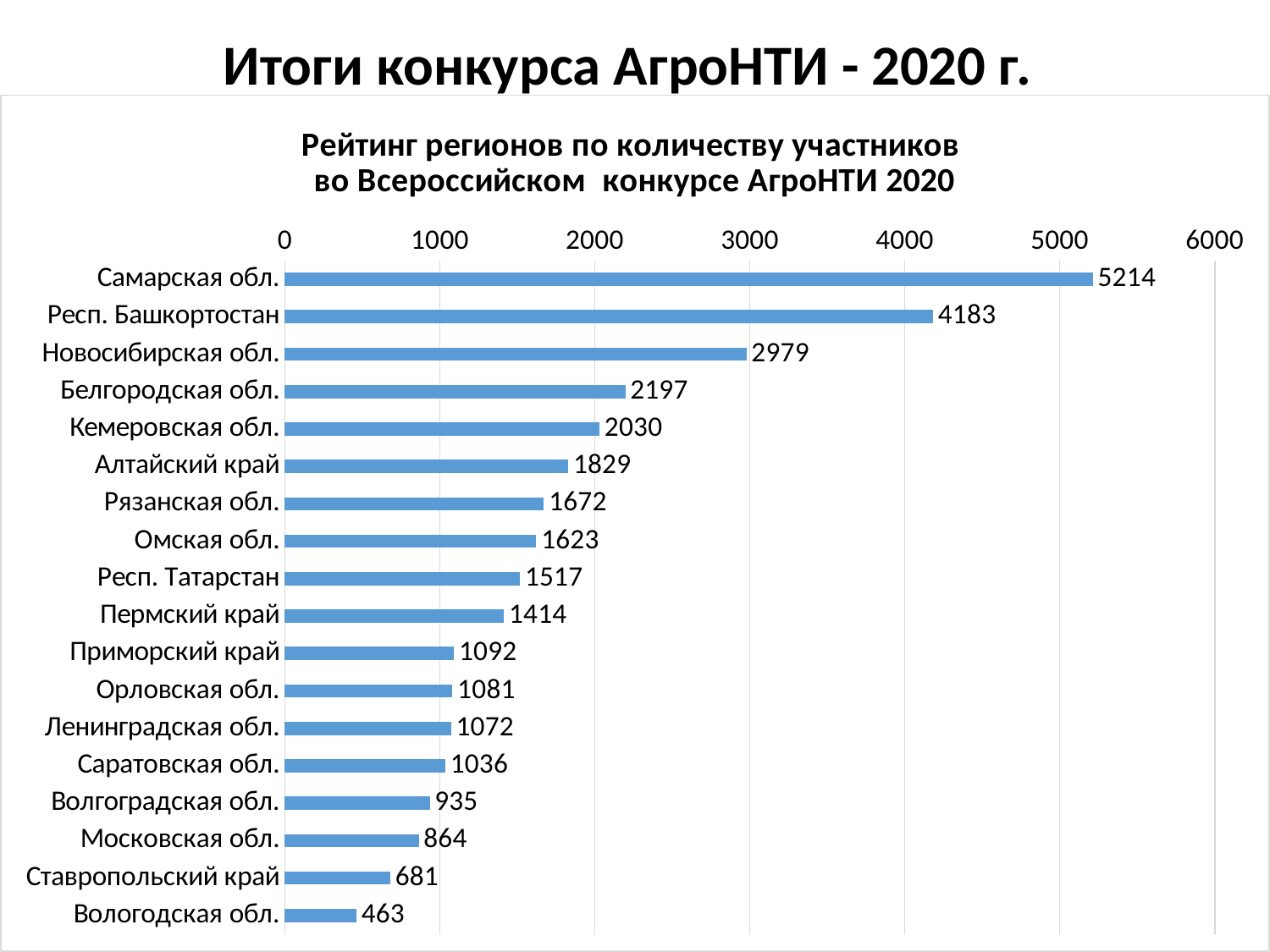
Is the value for Респ. Башкортостан greater or less than 4000? greater What is the difference between the values for Самарская обл. and Респ. Башкортостан? 1031 What is the value for Пермский край? 1414 What is the value for Самарская обл.? 5214 What is the value for Ставропольский край? 681 How many regions are shown in the chart? 18 What is the title of the chart? Рейтинг регионов по количеству участников во Всероссийском конкурсе АгроНТИ 2020 Which region has the lowest number of participants? Вологодская обл. Which is larger, the value for Новосибирская обл. or the value for Белгородская обл.? Новосибирская обл. Which region has the highest number of participants? Самарская обл. What kind of chart is shown on the slide? Bar chart What is the difference between the values for Кемеровская обл. and Алтайский край? 201